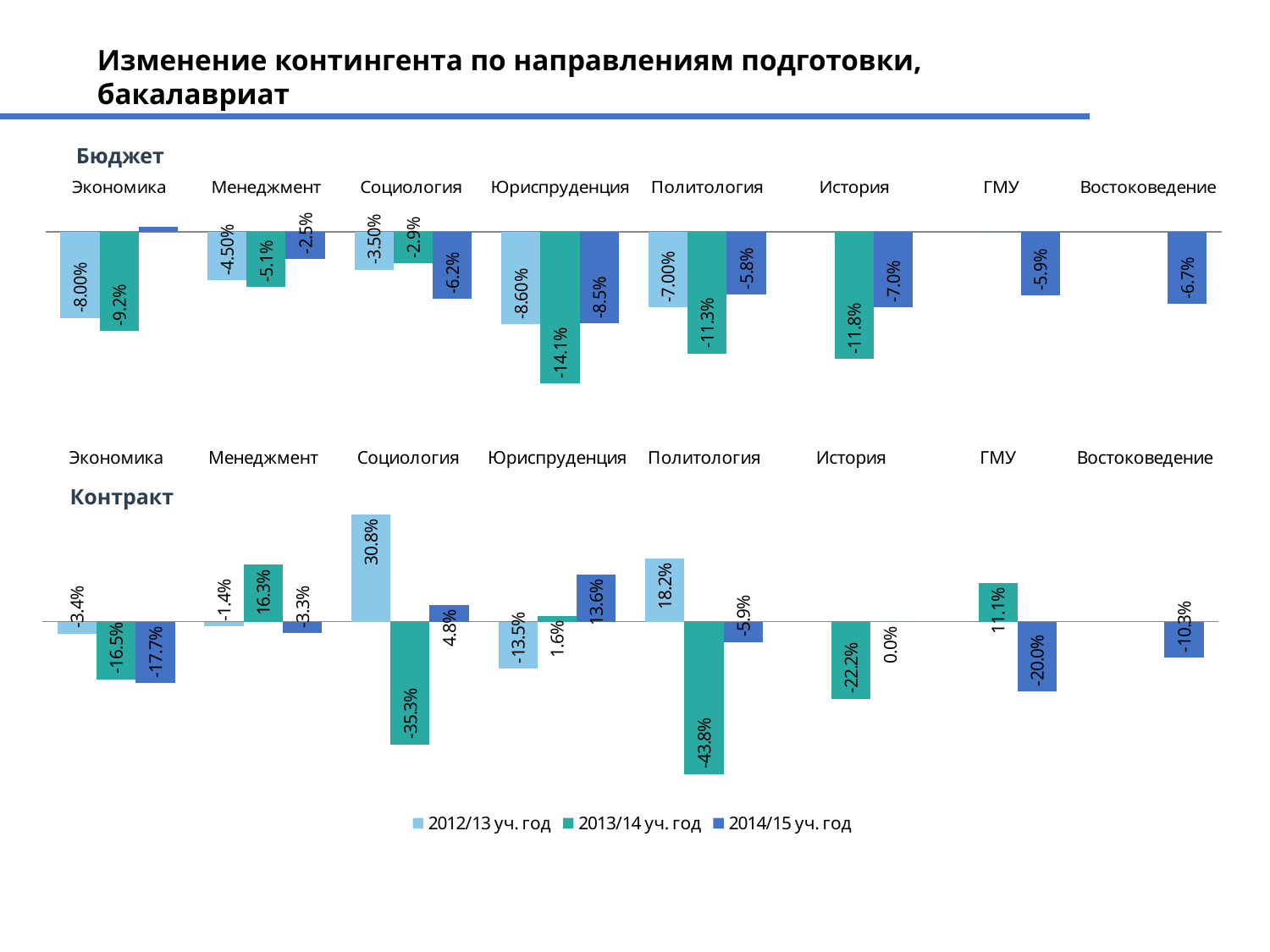
On the Контракт chart, which category has the lowest value in 2013/14 уч. год? Политология What kind of chart is the Бюджет chart? Bar chart On the Бюджет chart, what is the value for Юриспруденция in 2013/14 уч. год? -14.1% On the Контракт chart, what is the value for Политология in 2013/14 уч. год? -43.8% On the Контракт chart, which category has the highest value in 2012/13 уч. год? Социология On the Бюджет chart, which category has the lowest value in 2013/14 уч. год? Юриспруденция How many series does the legend list? 3 On the Бюджет chart, which is larger: the 2014/15 уч. год value for Менеджмент or for Социология? Менеджмент On the Бюджет chart, what is the value for Экономика in 2012/13 уч. год? -8.00% On the Контракт chart, what is the value for Социология in 2012/13 уч. год? 30.8% On the Контракт chart, what is the difference between the 2012/13 уч. год and 2013/14 уч. год values for Социология? 66.1 percentage points How many categories are shown on the Контракт chart? 8